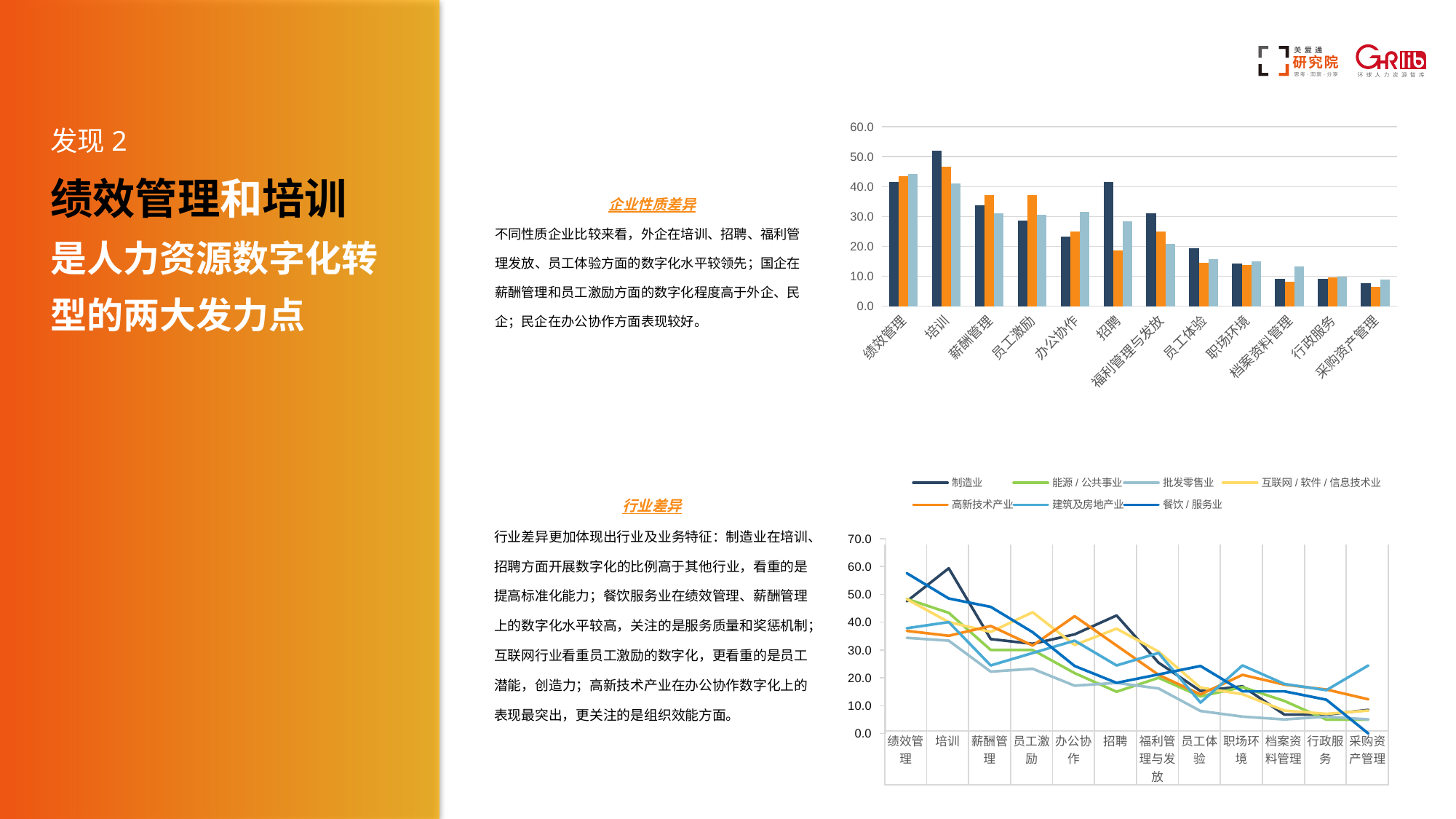
What kind of chart is the top chart on the slide? bar chart In the top bar chart, is the orange bar for 招聘 greater or less than 30? less How many categories are shown on the x axis of the top bar chart? 12 In the top bar chart, which category has the tallest bar? 培训 What kind of chart is the bottom chart on the slide? line chart In the top bar chart, which category has the shortest bars overall? 采购资产管理 In the top bar chart, for 招聘, is the dark blue bar or the orange bar taller? dark blue In the bottom line chart, do the values of 制造业 generally rise or fall from 绩效管理 to 采购资产管理? fall In the bottom line chart, which series has the highest value at 绩效管理? 餐饮 / 服务业 How many series does the legend of the bottom line chart list? 7 In the top bar chart, is the dark blue bar for 培训 greater or less than 40? greater In the bottom line chart, is the value of 制造业 at 培训 greater or less than 50? greater